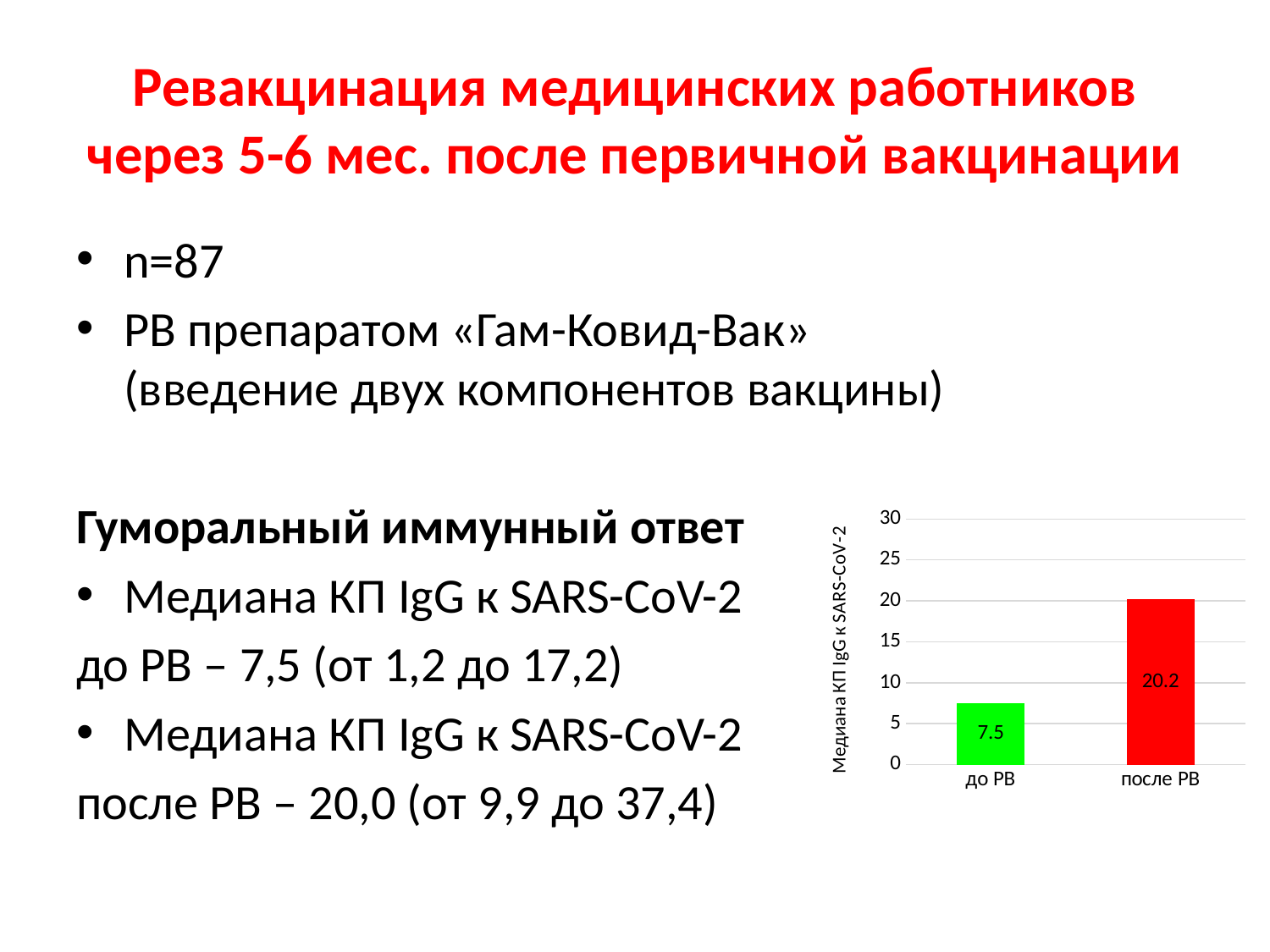
Is the value for "после РВ" greater or less than 15? greater What kind of chart is shown on the slide? bar chart What is the value for "после РВ" in the chart? 20.2 Is the value for "до РВ" greater or less than 10? less Which category has the lowest value in the chart? до РВ Do the values rise or fall from "до РВ" to "после РВ"? rise Which category has the highest value in the chart? после РВ What is the value for "до РВ" in the chart? 7.5 What is the label of the vertical axis of the chart? Медиана КП IgG к SARS-CoV-2 How many categories are shown in the chart? 2 What is the difference between the values for "после РВ" and "до РВ"? 12.7 Which is larger, the value for "до РВ" or for "после РВ"? после РВ